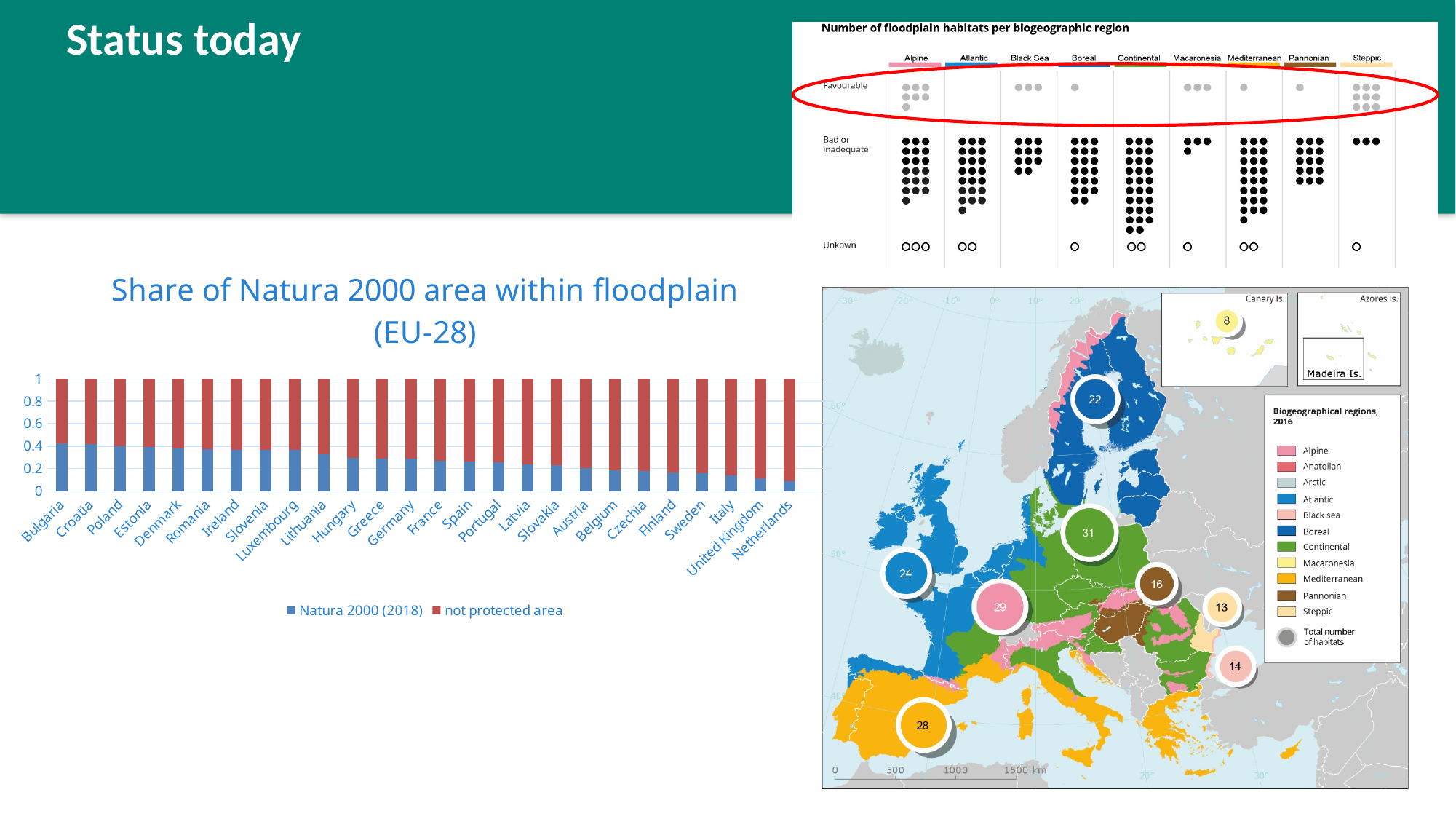
How many countries are shown on the x axis of the 'Share of Natura 2000 area within floodplain (EU-28)' chart? 26 On the map of biogeographical regions, which region has the lowest total number of habitats? Macaronesia In the 'Share of Natura 2000 area within floodplain (EU-28)' chart, which has the larger Natura 2000 (2018) share, Bulgaria or Netherlands? Bulgaria In the 'Share of Natura 2000 area within floodplain (EU-28)' chart, is the Natura 2000 (2018) value for Germany greater or less than 0.4? less In the 'Share of Natura 2000 area within floodplain (EU-28)' chart, is the Natura 2000 (2018) value for Poland greater or less than 0.2? greater In the 'Share of Natura 2000 area within floodplain (EU-28)' chart, which series is shown in blue? Natura 2000 (2018) How many series does the legend of the 'Share of Natura 2000 area within floodplain (EU-28)' chart list? 2 In the 'Share of Natura 2000 area within floodplain (EU-28)' chart, what is the total height of each stacked bar? 1 On the map of biogeographical regions, what is the total number of habitats shown for the Continental region? 31 In the 'Share of Natura 2000 area within floodplain (EU-28)' chart, is the Natura 2000 (2018) value for Netherlands greater or less than 0.2? less What kind of chart is 'Share of Natura 2000 area within floodplain (EU-28)'? bar chart In the 'Share of Natura 2000 area within floodplain (EU-28)' chart, do the Natura 2000 (2018) values rise or fall from left to right along the x axis? fall